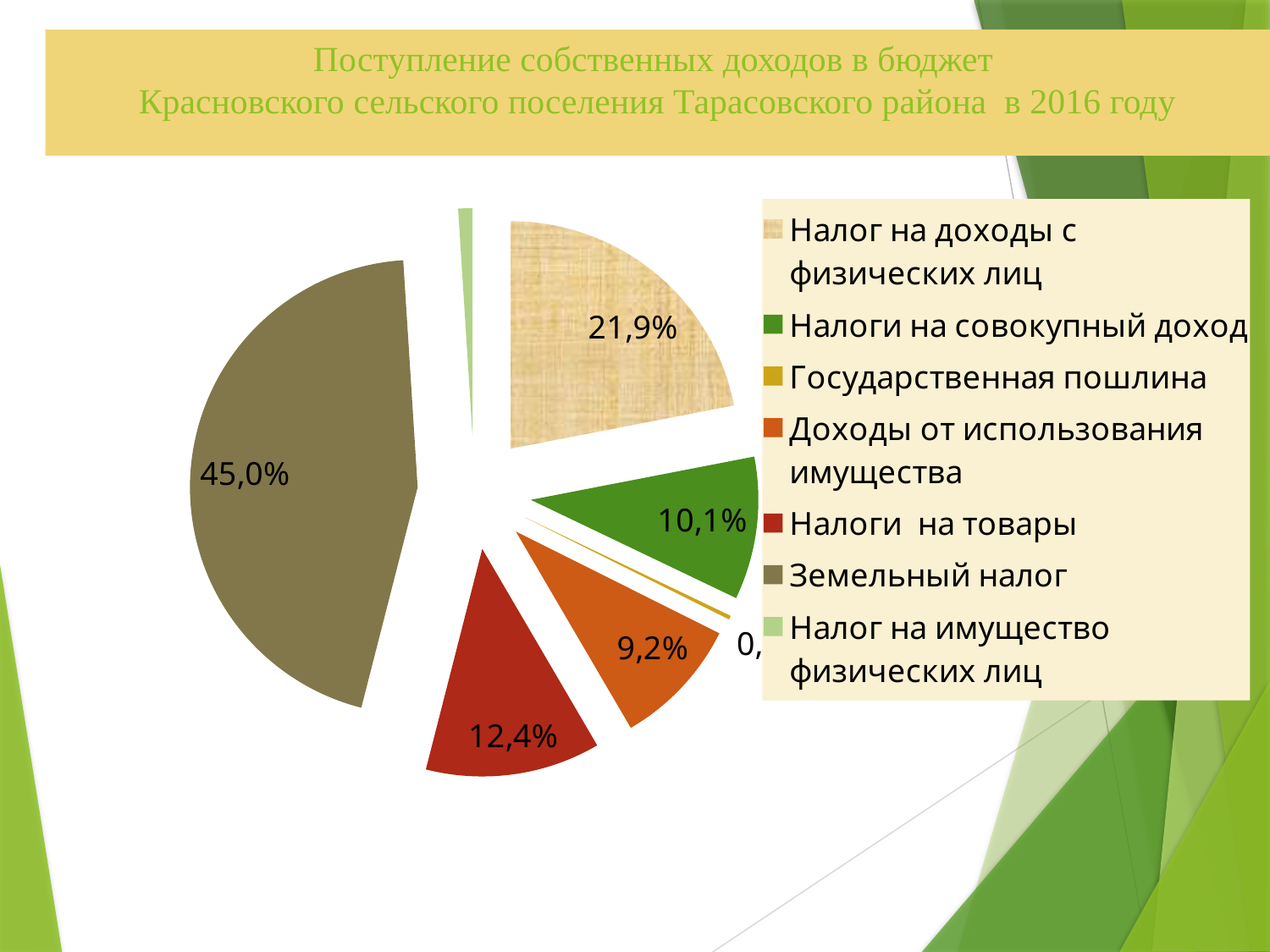
What is the value shown for Доходы от использования имущества? 9,2% What is the difference between the shares of Налог на доходы с физических лиц and Налоги на совокупный доход? 11,8% What is the value shown for Налоги на совокупный доход? 10,1% What kind of chart is shown on the slide? Pie chart What is the value shown for Налог на доходы с физических лиц? 21,9% What is the value shown for Налоги на товары? 12,4% Which category has the largest share of the pie? Земельный налог What share of the pie does Земельный налог account for? 45,0% How many categories does the legend list? 7 What is the difference between the shares of Земельный налог and Налог на доходы с физических лиц? 23,1% Which year does the chart title refer to? 2016 Which is larger: Налоги на товары or Доходы от использования имущества? Налоги на товары